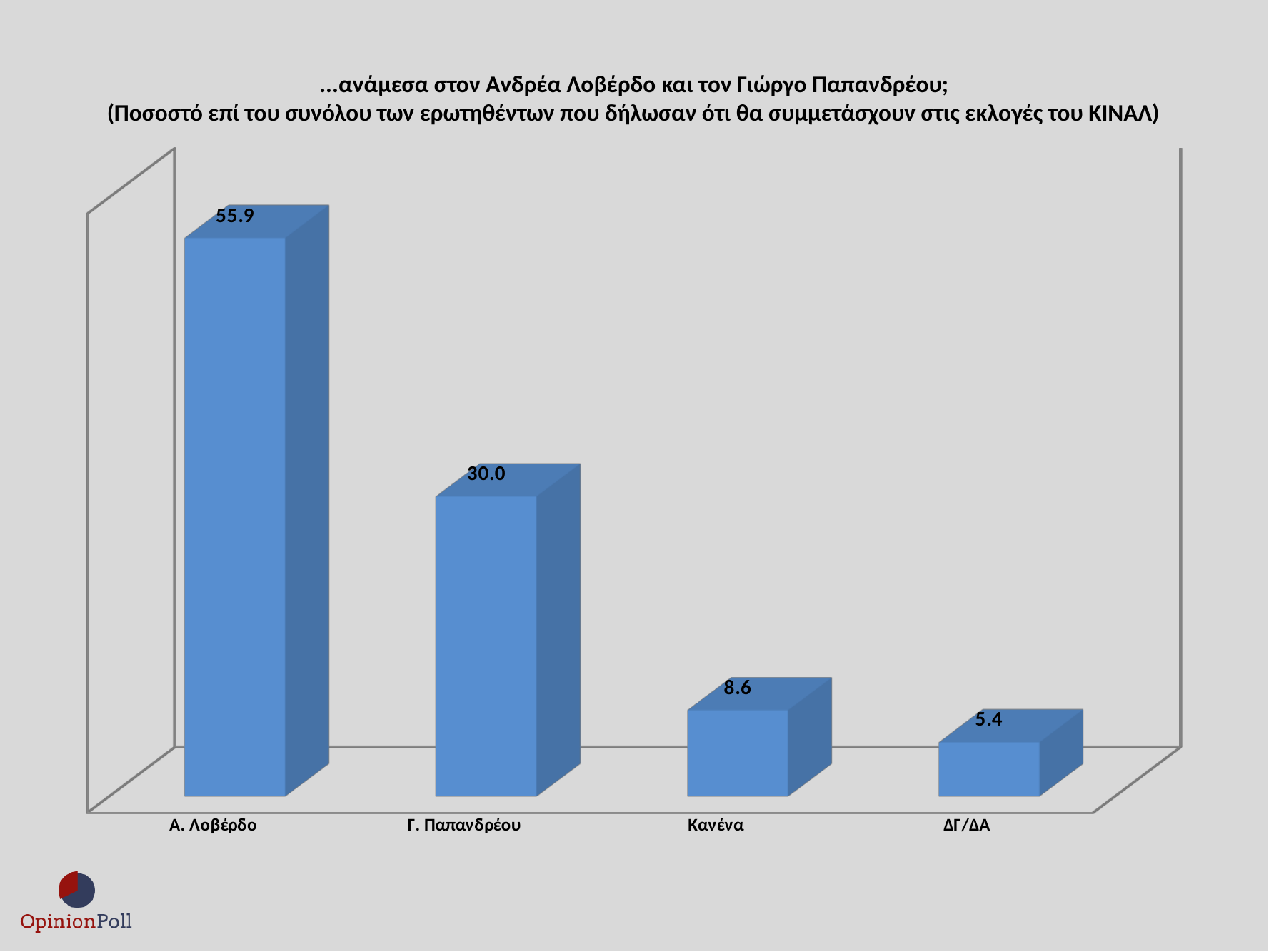
Which category has the lowest value? ΔΓ/ΔΑ What is the value for Α. Λοβέρδο? 55.9 Which is larger, the value for Γ. Παπανδρέου or the value for Κανένα? Γ. Παπανδρέου What is the value for ΔΓ/ΔΑ? 5.4 How many categories are shown in the chart? 4 What is the difference between the values for Α. Λοβέρδο and Γ. Παπανδρέου? 25.9 What kind of chart is shown on the slide? Bar chart Do the values rise or fall from left to right along the x axis? Fall Which category has the highest value? Α. Λοβέρδο What is the value for Γ. Παπανδρέου? 30.0 What is the difference between the values for Κανένα and ΔΓ/ΔΑ? 3.2 What is the value for Κανένα? 8.6